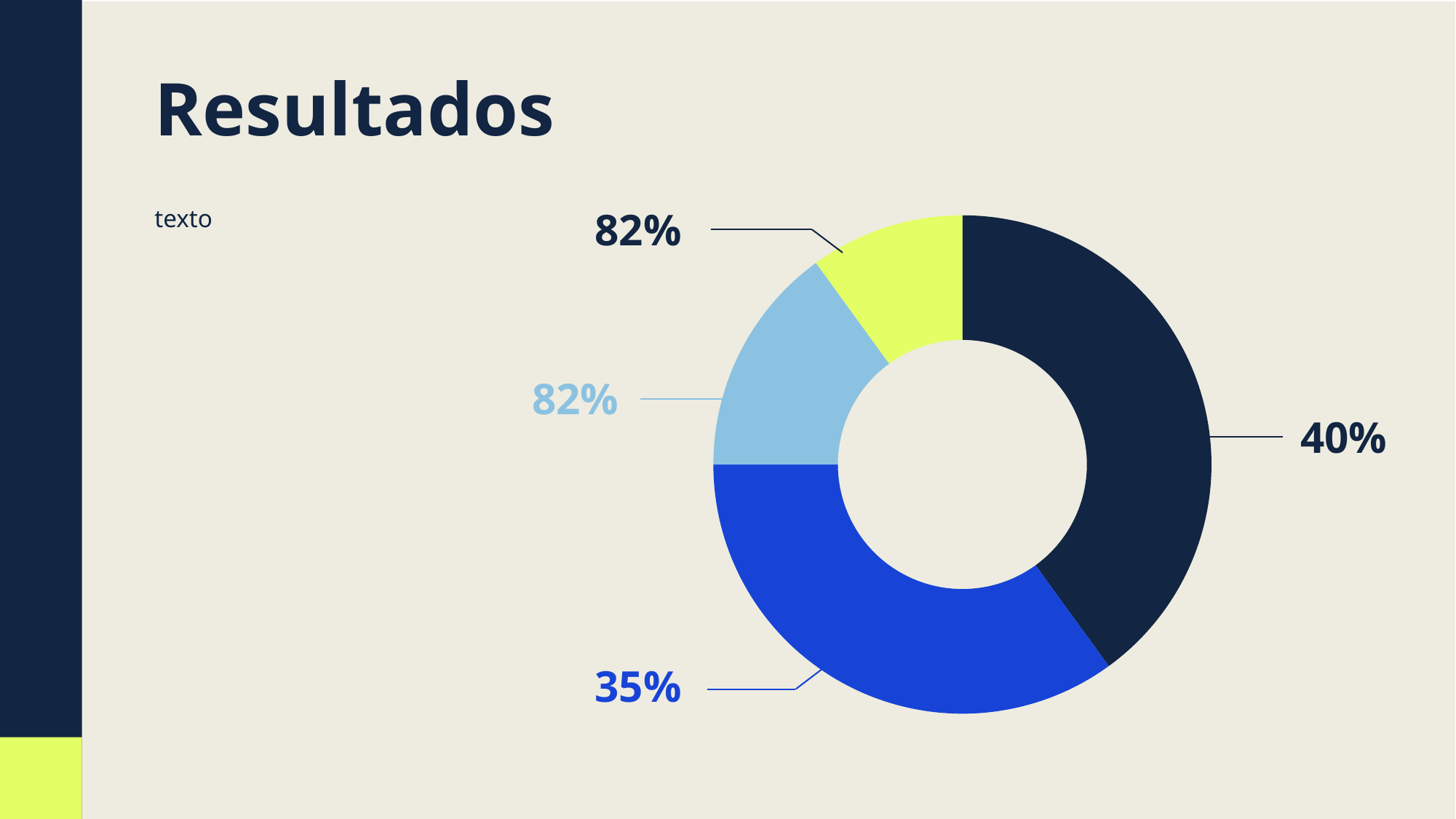
What value is labelled on the dark navy slice of the donut chart? 40% What is the difference between the labelled values of the dark navy slice (40%) and the bright blue slice (35%)? 5 percentage points What is the title of the slide containing the donut chart? Resultados What value is labelled on the yellow slice of the donut chart? 82% What value is labelled on the bright blue slice at the bottom of the donut chart? 35% Which slice of the donut chart is labelled 40%? The dark navy slice on the right How many slices does the donut chart have? 4 Which has the larger labelled value, the dark navy slice or the bright blue slice? The dark navy slice What value is labelled on the light blue slice of the donut chart? 82% What kind of chart is shown on the slide? Donut (pie) chart What is the smallest value labelled on the donut chart? 35% How many slices are labelled 82%? 2